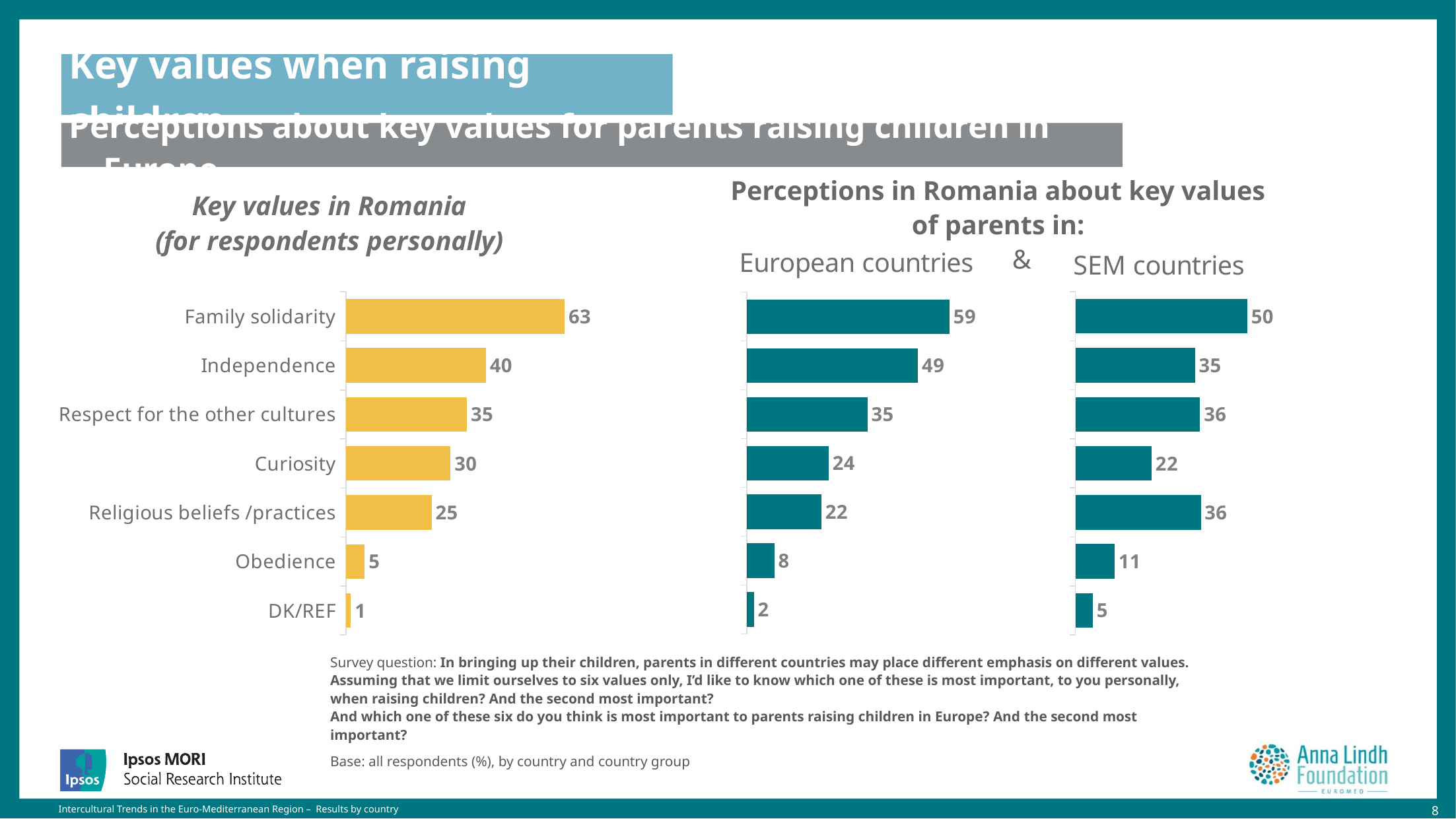
In the 'Key values in Romania (for respondents personally)' chart, which category has the lowest value? DK/REF In the 'SEM countries' chart, what is the value for Religious beliefs /practices? 36 What colour are the bars in the 'Key values in Romania (for respondents personally)' chart? Yellow In the 'Key values in Romania (for respondents personally)' chart, what is the value for Family solidarity? 63 In the 'Key values in Romania (for respondents personally)' chart, what is the value for Curiosity? 30 Which is larger: the value for Obedience in the 'European countries' chart or in the 'SEM countries' chart? SEM countries In the 'European countries' chart, what is the value for Independence? 49 What type of chart is the 'Key values in Romania (for respondents personally)' chart? Bar chart In the 'Key values in Romania (for respondents personally)' chart, how many categories are shown? 7 In the 'SEM countries' chart, which category has the highest value? Family solidarity In the 'European countries' chart, what is the difference between the values for Family solidarity and Independence? 10